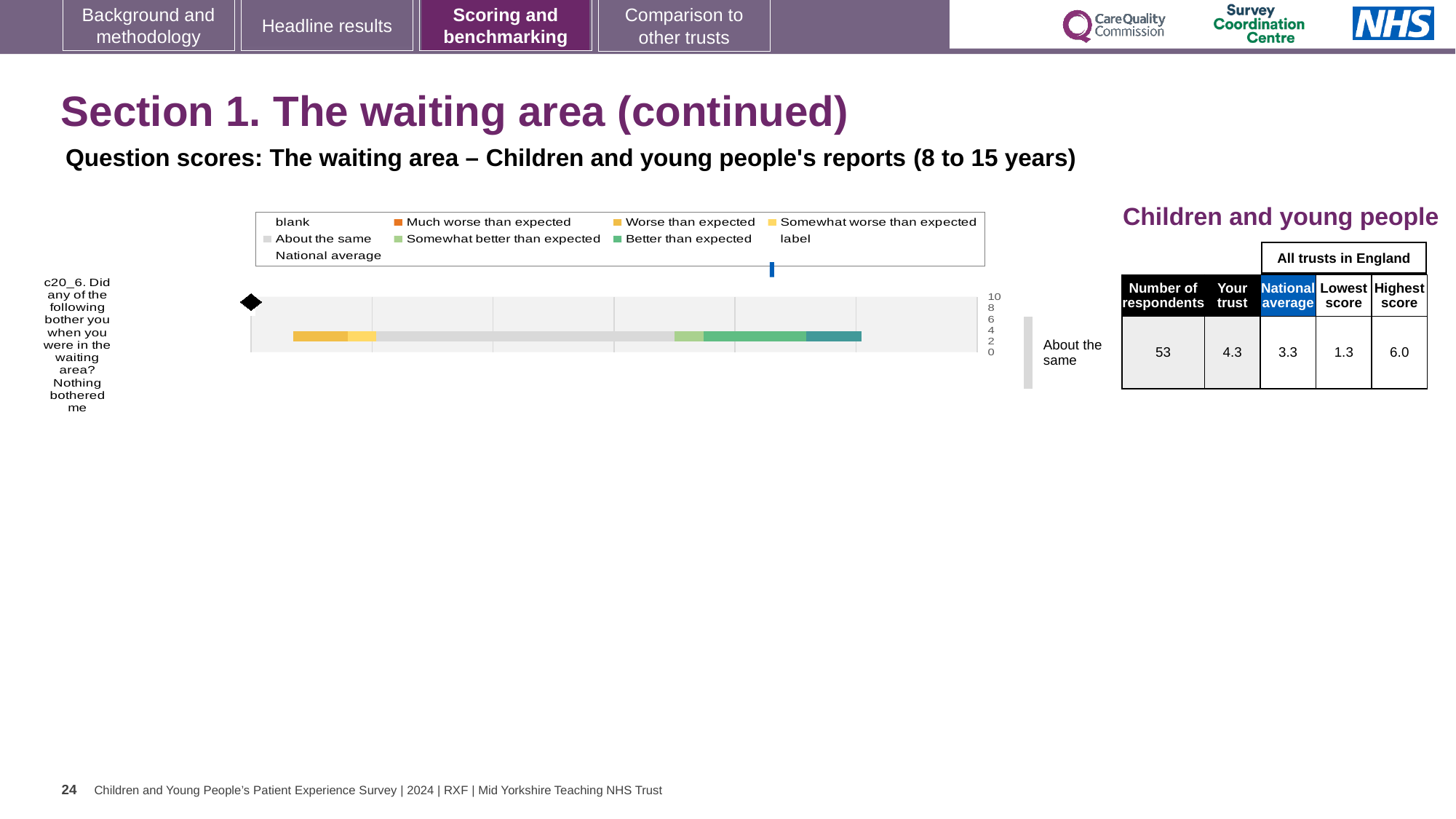
What kind of chart is shown on the slide? bar chart In the table next to the chart, what is the lowest score among all trusts in England for question c20_6? 1.3 In the table next to the chart, what is the highest score among all trusts in England for question c20_6? 6.0 In the table next to the chart, what is the 'Your trust' score for question c20_6? 4.3 What benchmark category label is shown to the right of the bar for question c20_6? About the same In the table next to the chart, what is the number of respondents for question c20_6? 53 What is the difference between the 'Your trust' score and the national average for question c20_6? 1.0 Which question is plotted in the bar chart? c20_6. Did any of the following bother you when you were in the waiting area? Nothing bothered me How many entries does the chart legend list? 9 Which is larger for question c20_6: the 'Your trust' score or the national average? Your trust In the table next to the chart, what is the national average score for question c20_6? 3.3 How many question categories are plotted in the bar chart? 1